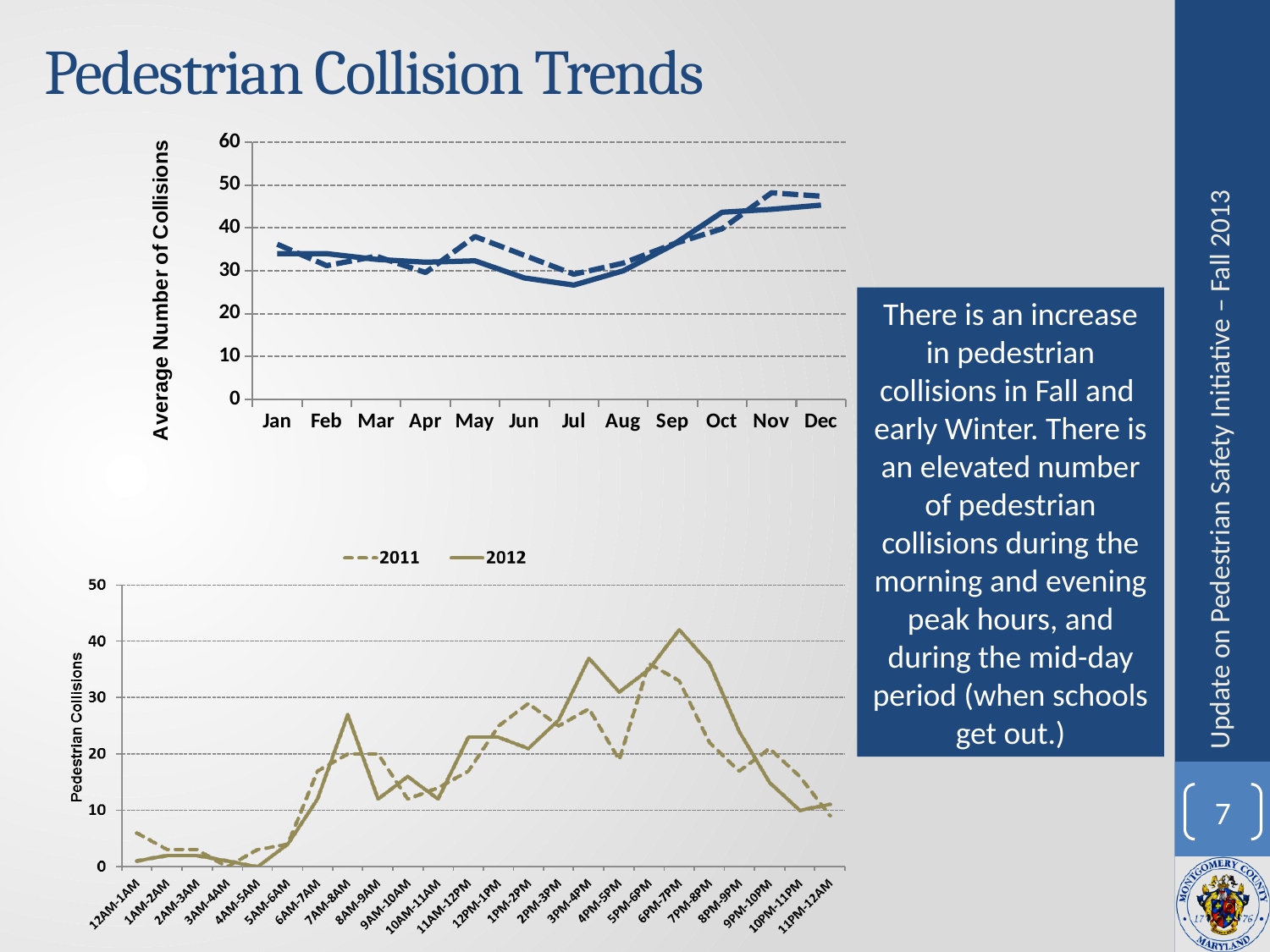
How many time periods are shown on the x axis of the bottom chart? 24 In the top chart, do the values of the solid line rise or fall from Jul to Nov? rise What kind of chart is the top chart on the slide? line chart In the bottom chart, is the 2012 value for 7AM-8AM greater or less than 20? greater What is the y-axis title of the top chart? Average Number of Collisions How many months are shown on the x axis of the top chart? 12 How many series does the legend of the bottom chart list? 2 In the bottom chart, which series has the larger value at 6PM-7PM, 2011 or 2012? 2012 In the top chart, is the value of the solid line for Jul greater or less than 30? less In the bottom chart, which time period has the highest value for 2012? 6PM-7PM In the top chart, is the value of the dashed line for Nov greater or less than 40? greater In the top chart, which month has the lowest value on the solid line? Jul